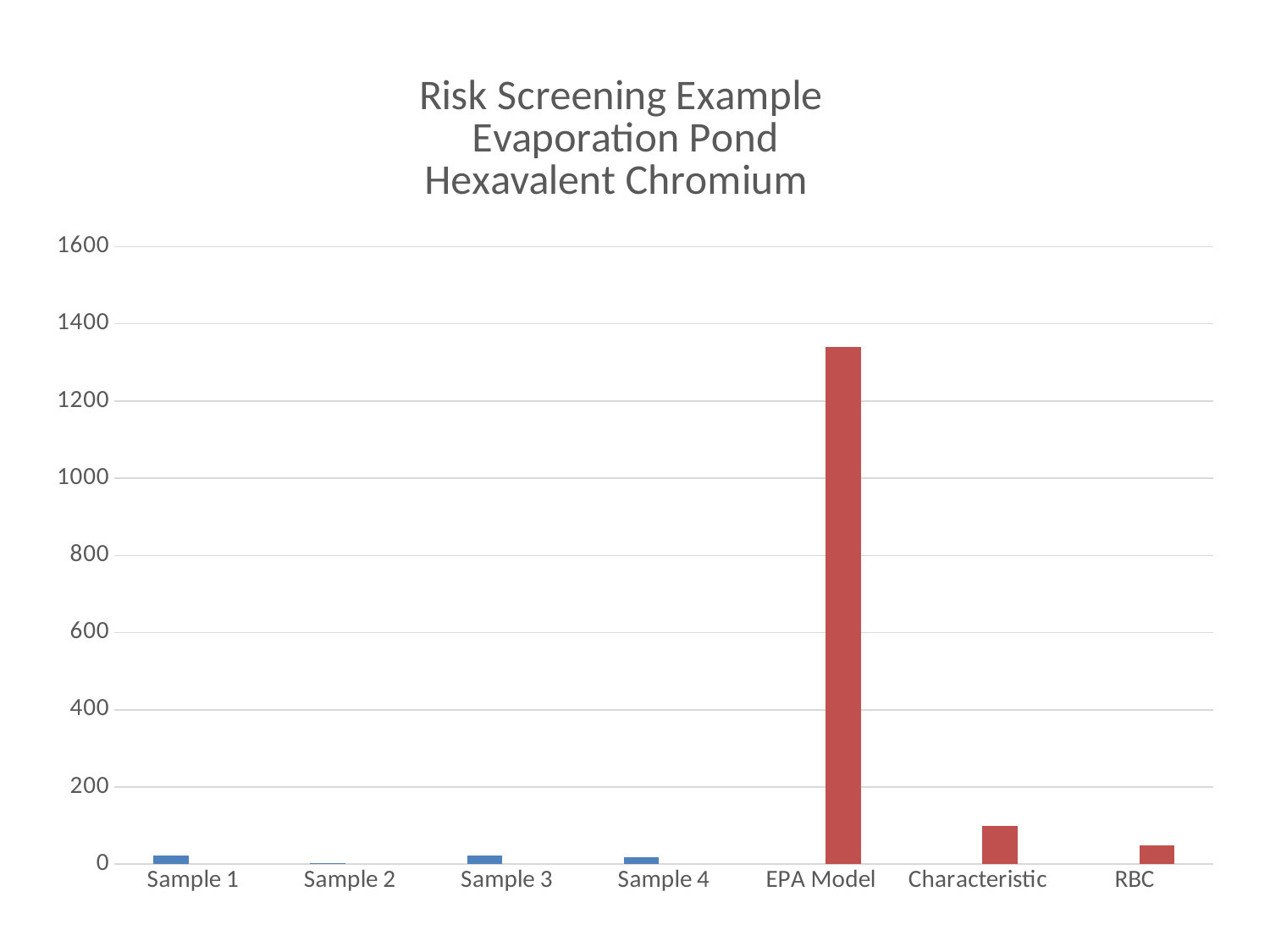
Which category has the lowest value? Sample 2 Which is larger, the value for EPA Model or the value for Characteristic? EPA Model What is the third line of the chart title? Hexavalent Chromium Is the value for EPA Model greater or less than 1400? less Which is larger, the value for Characteristic or the value for RBC? Characteristic How many categories are plotted along the x axis? 7 Is the value for Characteristic greater or less than 200? less What kind of chart is shown on the slide? bar chart Which category has the highest value? EPA Model Is the value for EPA Model greater or less than 1200? greater Which is larger, the value for Sample 1 or the value for Sample 2? Sample 1